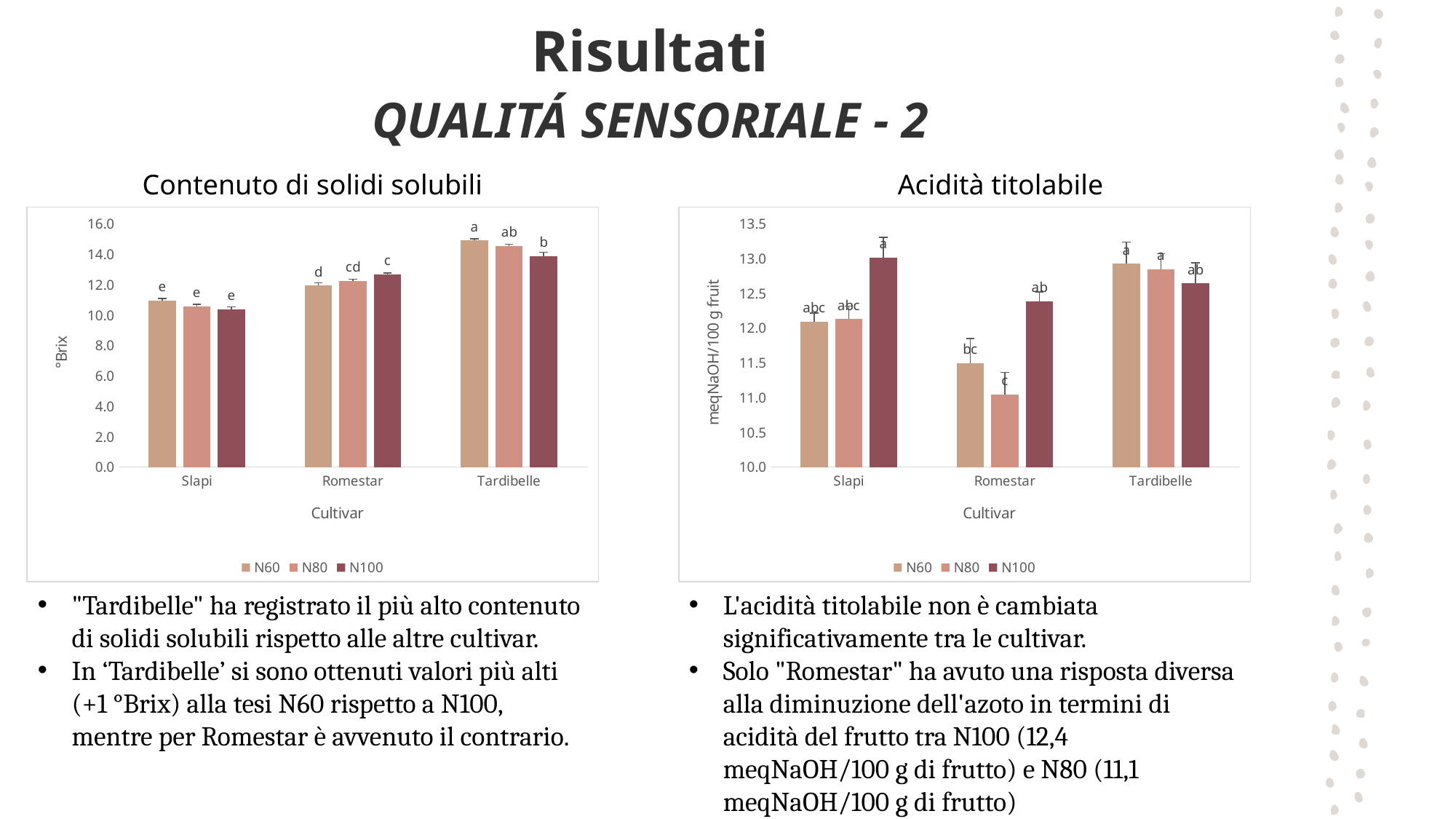
In the 'Contenuto di solidi solubili' chart, is the value for Tardibelle N60 greater or less than 14.0? greater In the 'Contenuto di solidi solubili' chart, which is larger, the N100 bar for Romestar or the N100 bar for Slapi? Romestar In the 'Contenuto di solidi solubili' chart, is the value for Slapi N100 greater or less than 12.0? less In the 'Contenuto di solidi solubili' chart, how many series does the legend list? 3 In the 'Acidità titolabile' chart, how many cultivars are shown on the x axis? 3 In the 'Contenuto di solidi solubili' chart, do the N60 bars rise or fall from Slapi to Tardibelle? rise In the 'Contenuto di solidi solubili' chart, what kind of chart is shown? bar chart In the 'Contenuto di solidi solubili' chart, which cultivar has the lowest N60 bar? Slapi In the 'Acidità titolabile' chart, is the value for Romestar N100 greater or less than 12.0? greater In the 'Contenuto di solidi solubili' chart, which cultivar has the highest N60 bar? Tardibelle In the 'Acidità titolabile' chart, which cultivar and series has the lowest bar? Romestar N80 In the 'Acidità titolabile' chart, what is the label on the y axis? meqNaOH/100 g fruit